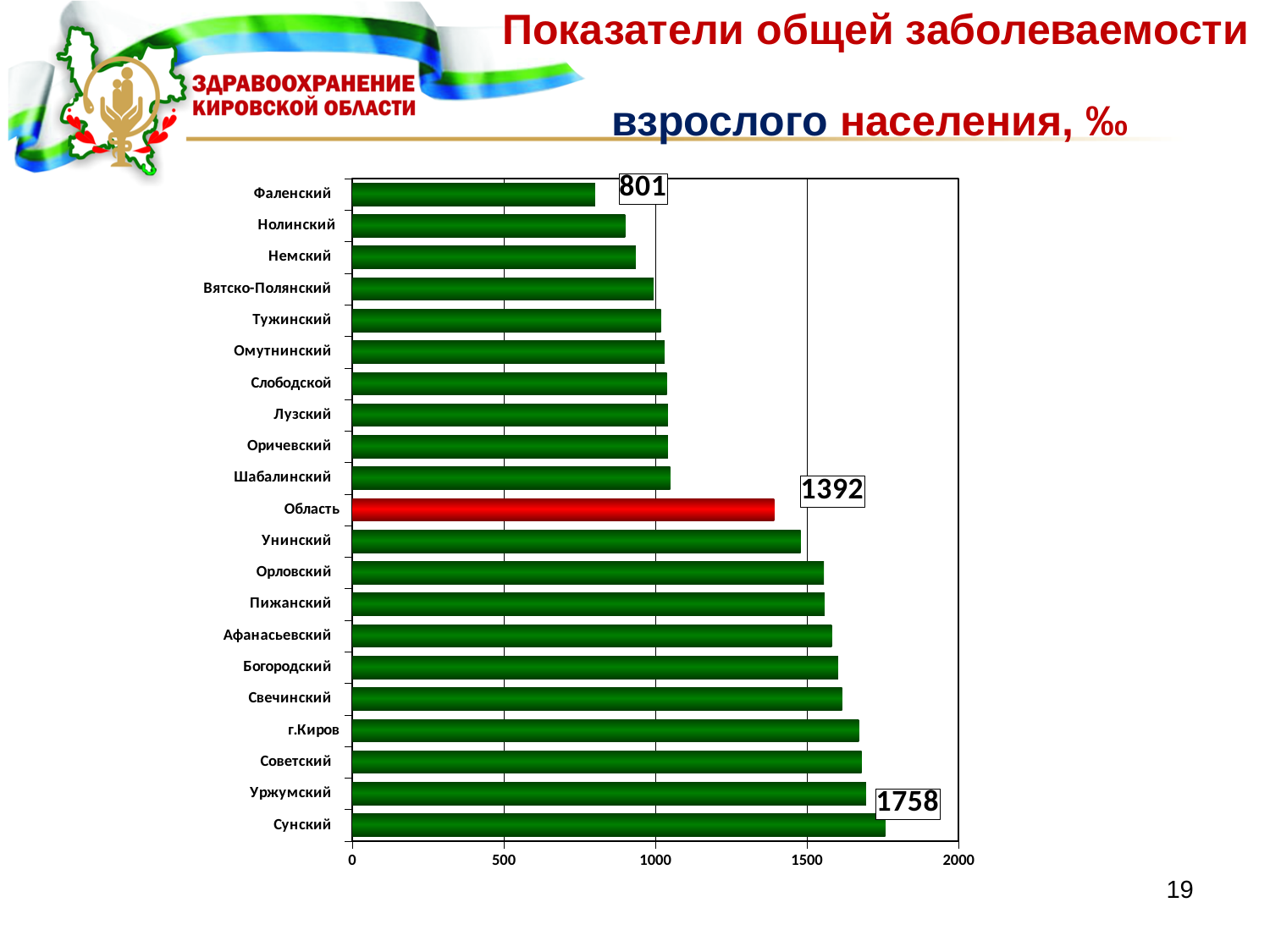
Which is larger, the value for Орловский or the value for Нолинский? Орловский Which category has the lowest value? Фаленский What is the value for Сунский? 1758 What is the difference between the values for Сунский and Фаленский? 957 What is the value for Фаленский? 801 What kind of chart is shown on the slide? bar chart Which category has the highest value? Сунский Is the value for Богородский greater or less than 1500? greater How many categories are shown on the chart? 21 Is the value for Нолинский greater or less than 1000? less What is the difference between the values for Область and Фаленский? 591 What is the value for Область? 1392